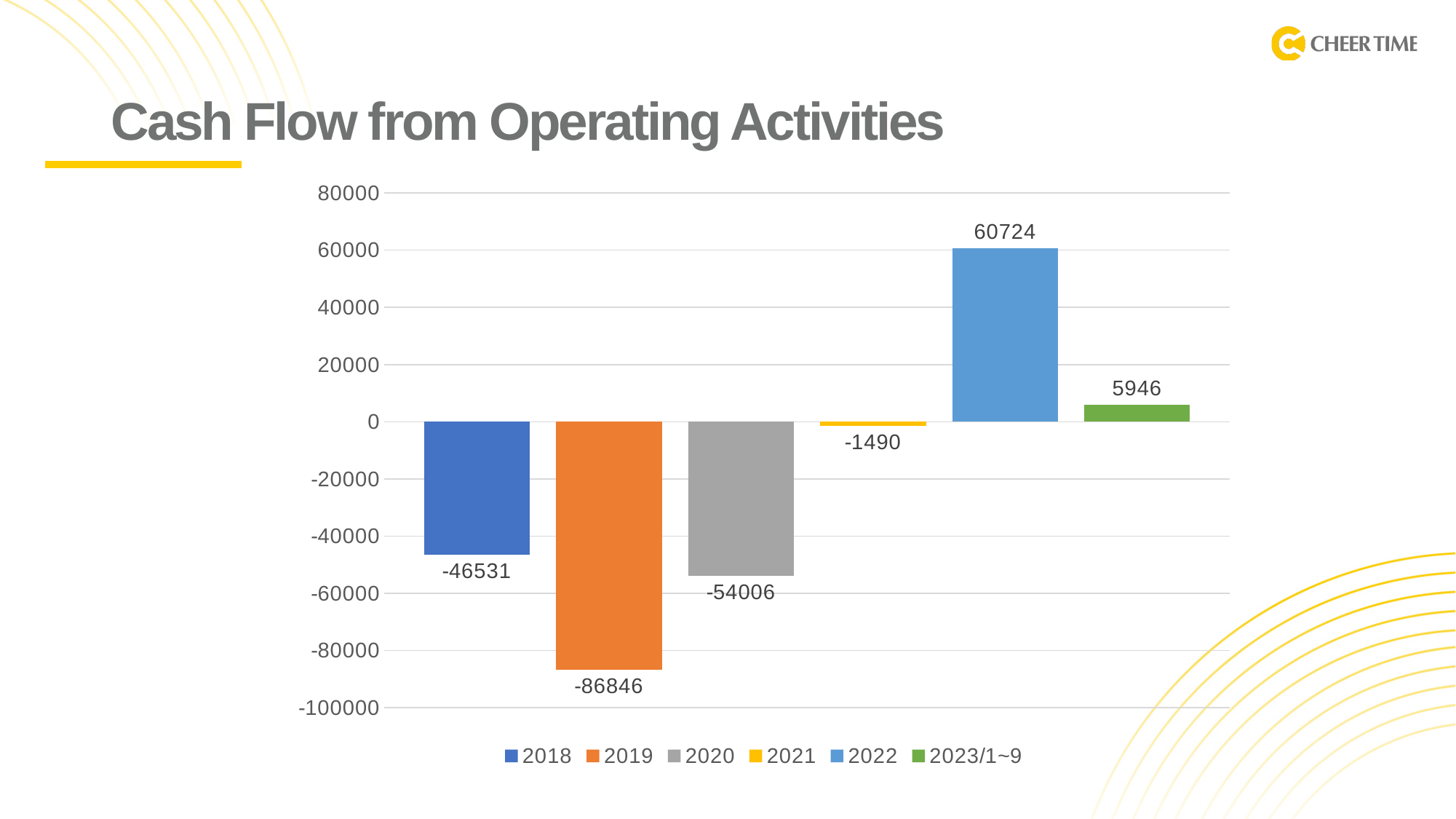
What is the cash flow from operating activities for 2022? 60724 Which year has the highest cash flow from operating activities? 2022 What is the value shown for 2023/1~9? 5946 What is the value shown for 2021? -1490 What is the cash flow from operating activities for 2019? -86846 What kind of chart is shown on the slide? Bar chart Which is larger, the value for 2018 or the value for 2020? 2018 How many bars are plotted in the chart? 6 How many entries does the legend list? 6 What is the difference between the 2022 value and the 2023/1~9 value? 54778 Which year has the lowest cash flow from operating activities? 2019 What is the title of the slide? Cash Flow from Operating Activities